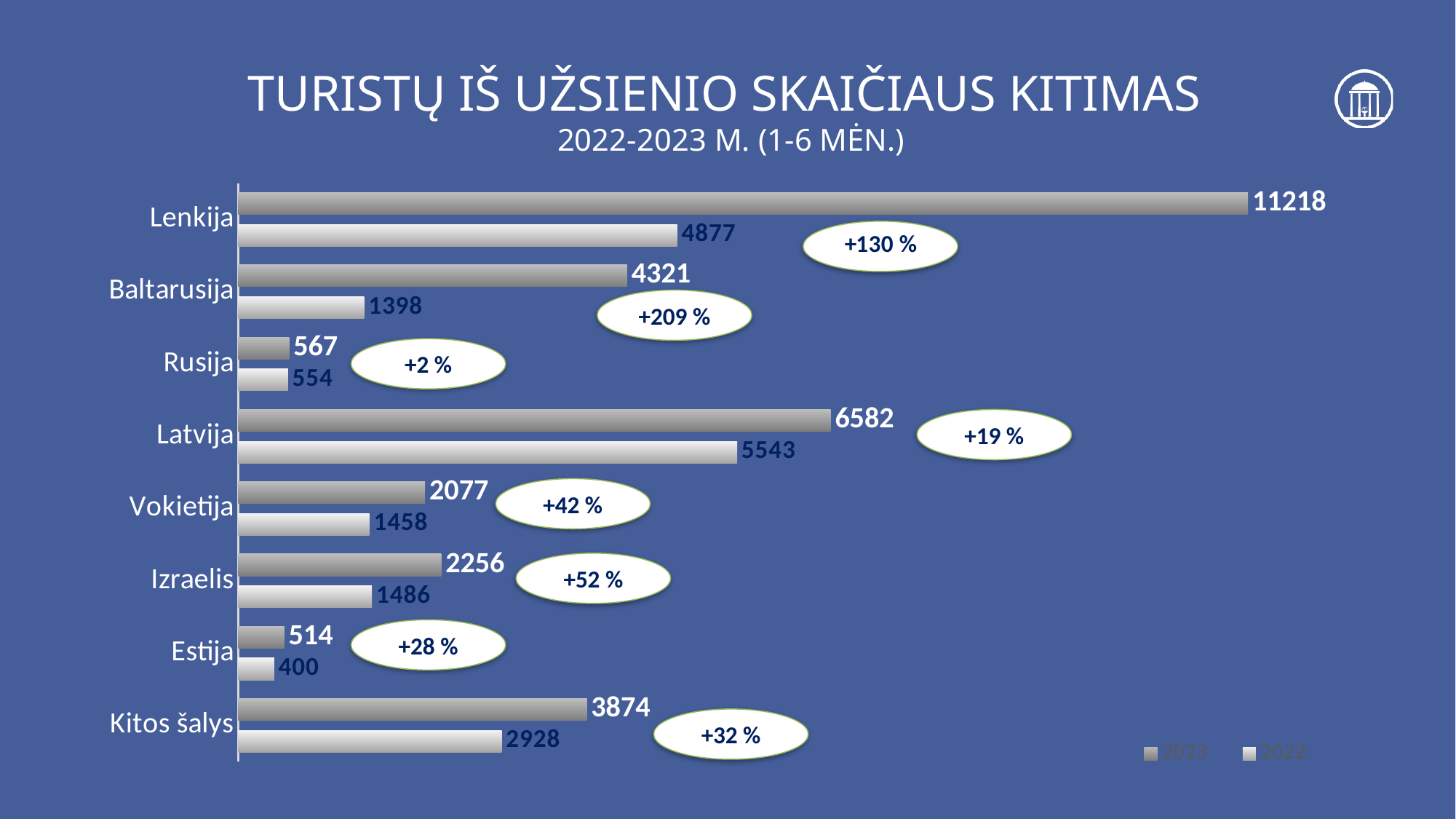
How many categories are shown on the chart? 8 How many series does the legend list? 2 What is the title of the chart? TURISTŲ IŠ UŽSIENIO SKAIČIAUS KITIMAS 2022-2023 M. (1-6 MĖN.) What is the 2023 value for Lenkija? 11218 Which category has the highest 2023 value? Lenkija What is the 2023 value for Latvija? 6582 What percentage change is shown for Baltarusija? +209 % What kind of chart is shown on the slide? bar chart What is the difference between the 2023 and 2022 values for Vokietija? 619 What is the 2022 value for Baltarusija? 1398 Which is larger: the 2023 value for Izraelis or the 2023 value for Vokietija? Izraelis Which category has the lowest 2022 value? Estija